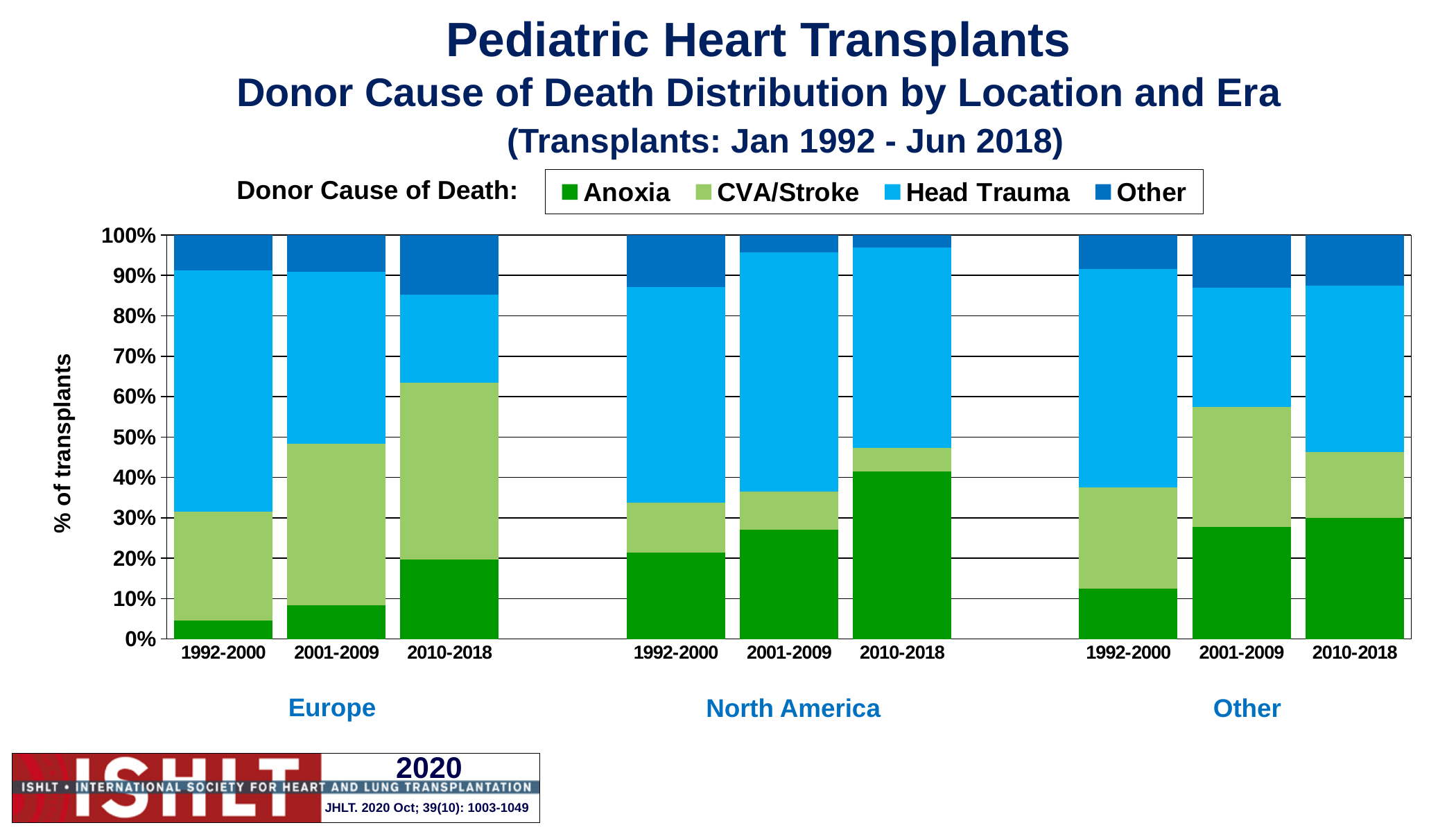
What is the total of each stacked bar? 100% Which has the larger Anoxia share in 2010-2018, Europe or North America? North America Which location and era bar has the smallest Anoxia segment? Europe 1992-2000 Is the Anoxia share for Europe in 1992-2000 greater or less than 10%? less How many bars are plotted in the chart? 9 Does the Anoxia share in Europe rise or fall from 1992-2000 to 2010-2018? rise What kind of chart is shown on the slide? Stacked bar chart What is the label on the y axis? % of transplants How many donor causes of death does the legend list? 4 Is the Anoxia share for North America in 2010-2018 greater or less than 40%? greater Is the Anoxia share for Other in 1992-2000 greater or less than 10%? greater Which location and era bar has the largest Anoxia segment? North America 2010-2018